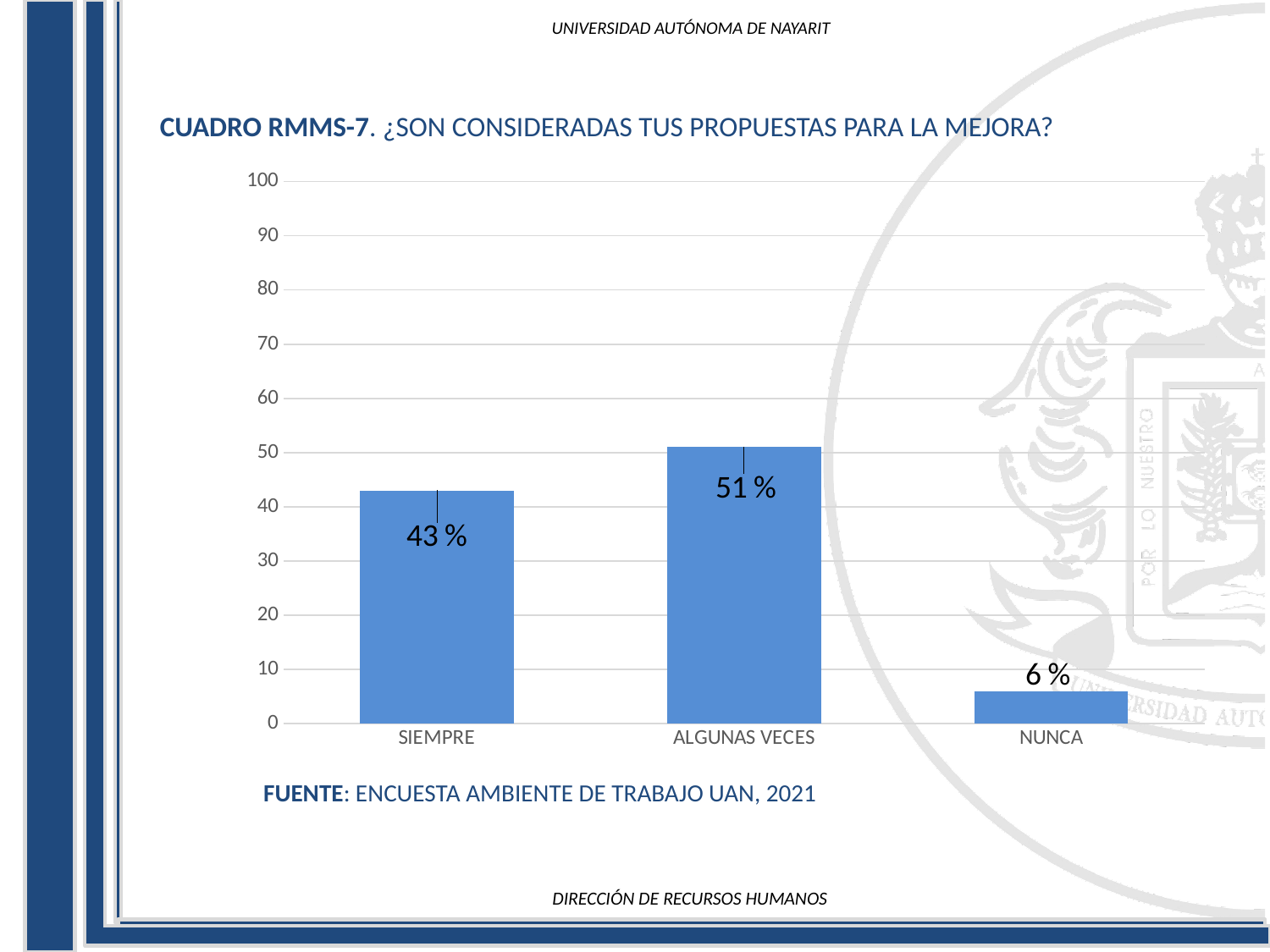
What is the value for ALGUNAS VECES? 51 % What is the difference between the values for ALGUNAS VECES and SIEMPRE? 8 % Is the value for ALGUNAS VECES greater or less than 50? greater Which category has the lowest value? NUNCA How many categories are shown on the x axis? 3 What is the value for NUNCA? 6 % What is the value for SIEMPRE? 43 % What kind of chart is shown on the slide? bar chart Which is larger, the value for SIEMPRE or the value for NUNCA? SIEMPRE What is the difference between the values for SIEMPRE and NUNCA? 37 % Which category has the highest value? ALGUNAS VECES What is the title of the chart? CUADRO RMMS-7. ¿SON CONSIDERADAS TUS PROPUESTAS PARA LA MEJORA?